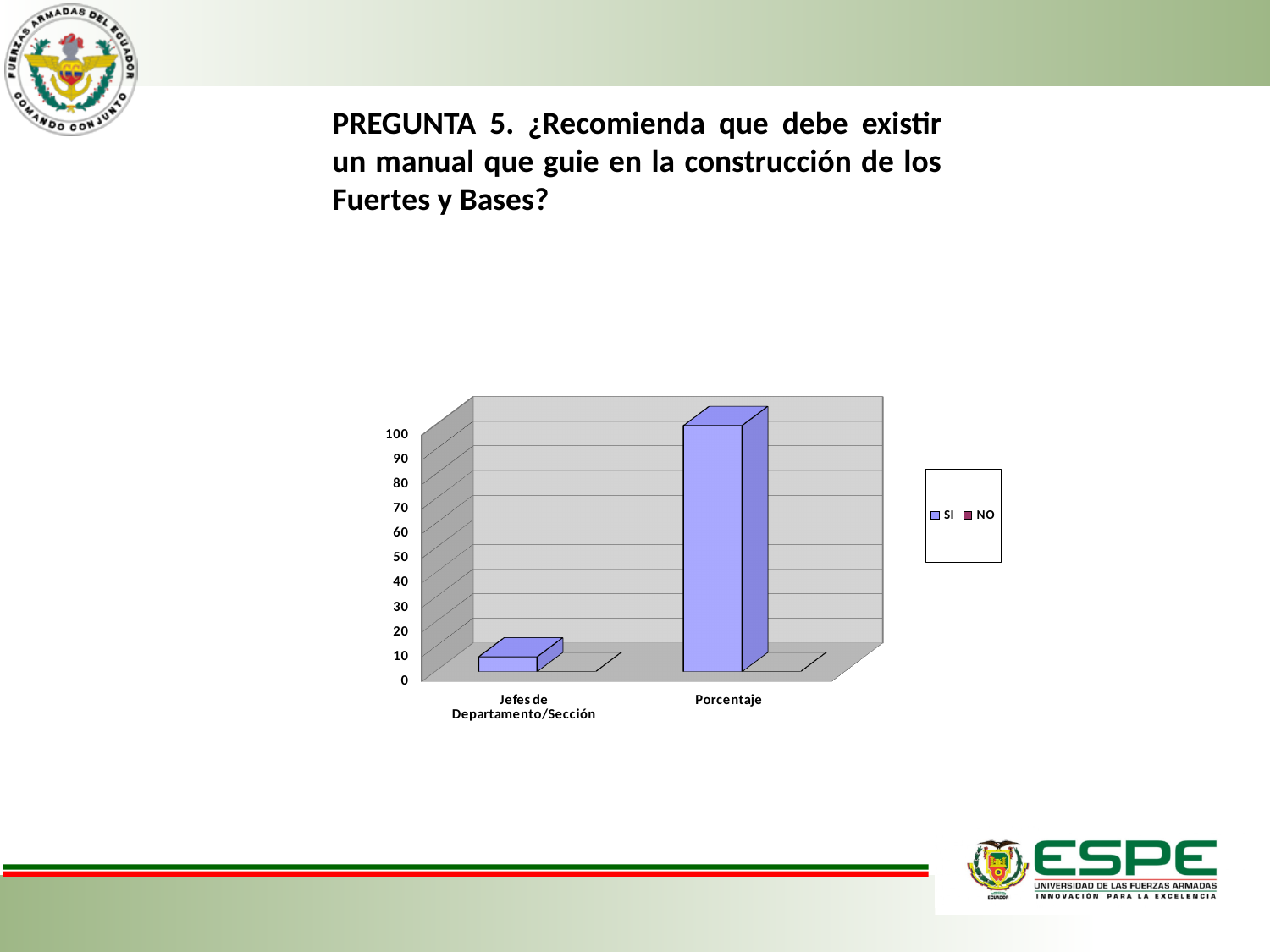
What kind of chart is shown on the slide? bar chart How many series does the chart's legend list? 2 Is the value for Jefes de Departamento/Sección greater or less than 50? less Which category has the lowest bar in the chart? Jefes de Departamento/Sección How many categories are shown on the x axis of the chart? 2 Is the value for Porcentaje greater or less than 80? greater Is the value for Porcentaje greater or less than 50? greater What is the highest value shown on the chart's vertical axis? 100 What are the two entries listed in the chart's legend? SI and NO Which category has the highest bar in the chart? Porcentaje Which is larger, the bar for Porcentaje or the bar for Jefes de Departamento/Sección? Porcentaje